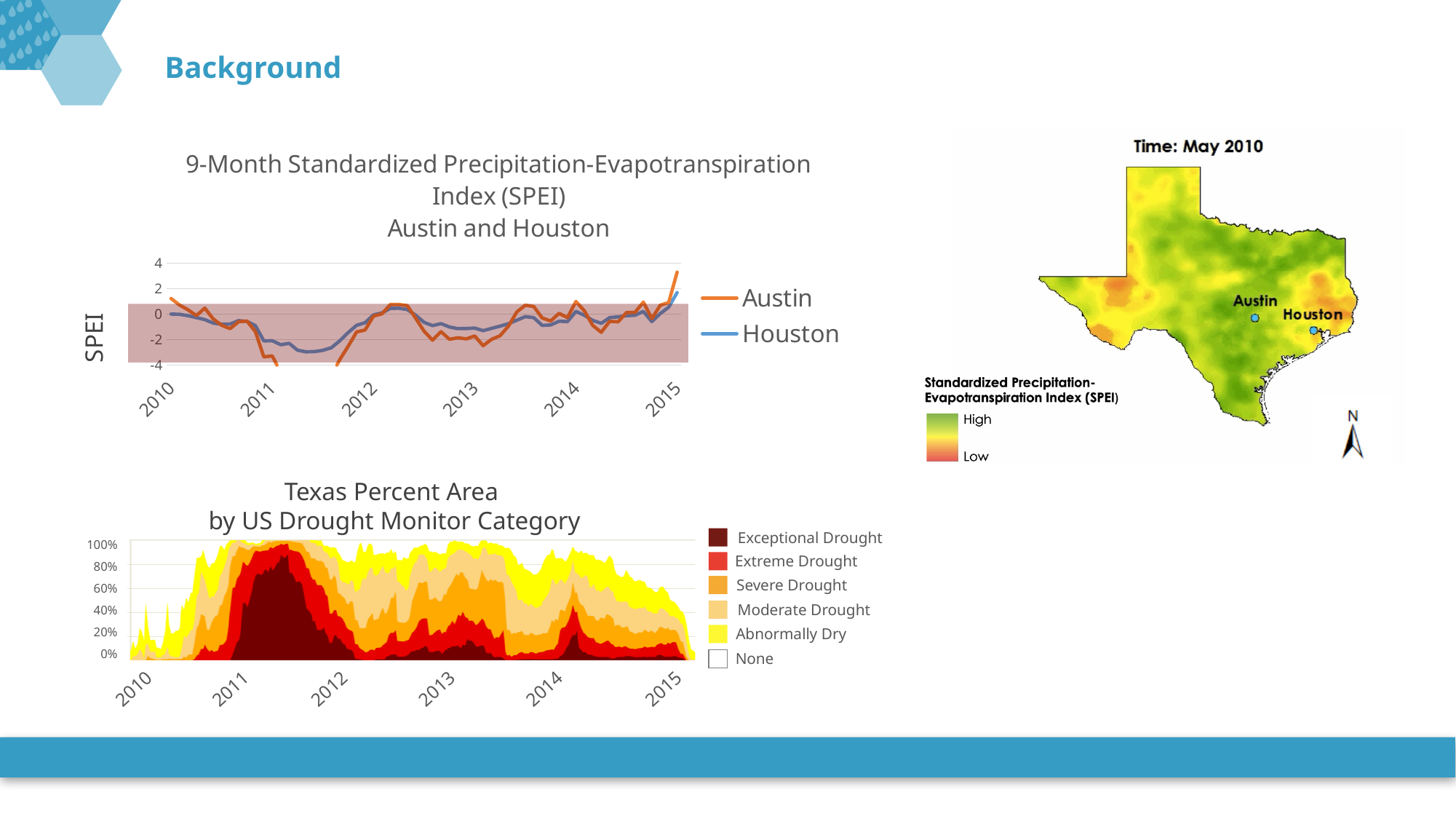
In the SPEI chart, is the lowest Austin value in 2011 greater or less than -2? less What is the y-axis label of the SPEI chart? SPEI In the 'Texas Percent Area by US Drought Monitor Category' chart, which category is shown in the darkest red? Exceptional Drought In the 'Texas Percent Area by US Drought Monitor Category' chart, in which year does the Exceptional Drought area reach its peak? 2011 How many series does the legend of the SPEI chart list? 2 In the 'Texas Percent Area by US Drought Monitor Category' chart, is the total area in drought categories in mid-2011 greater or less than 80%? greater What type of chart is the 'Texas Percent Area by US Drought Monitor Category' chart? Stacked area chart In the SPEI chart, is the Austin value at the end of the series (2015) greater or less than 2? greater In the SPEI chart, which series is drawn in orange? Austin How many categories does the legend of the 'Texas Percent Area by US Drought Monitor Category' chart list? 6 In the SPEI chart, at the end of the series in 2015, which series has the higher value, Austin or Houston? Austin What type of chart is the '9-Month Standardized Precipitation-Evapotranspiration Index (SPEI) Austin and Houston' chart? Line chart